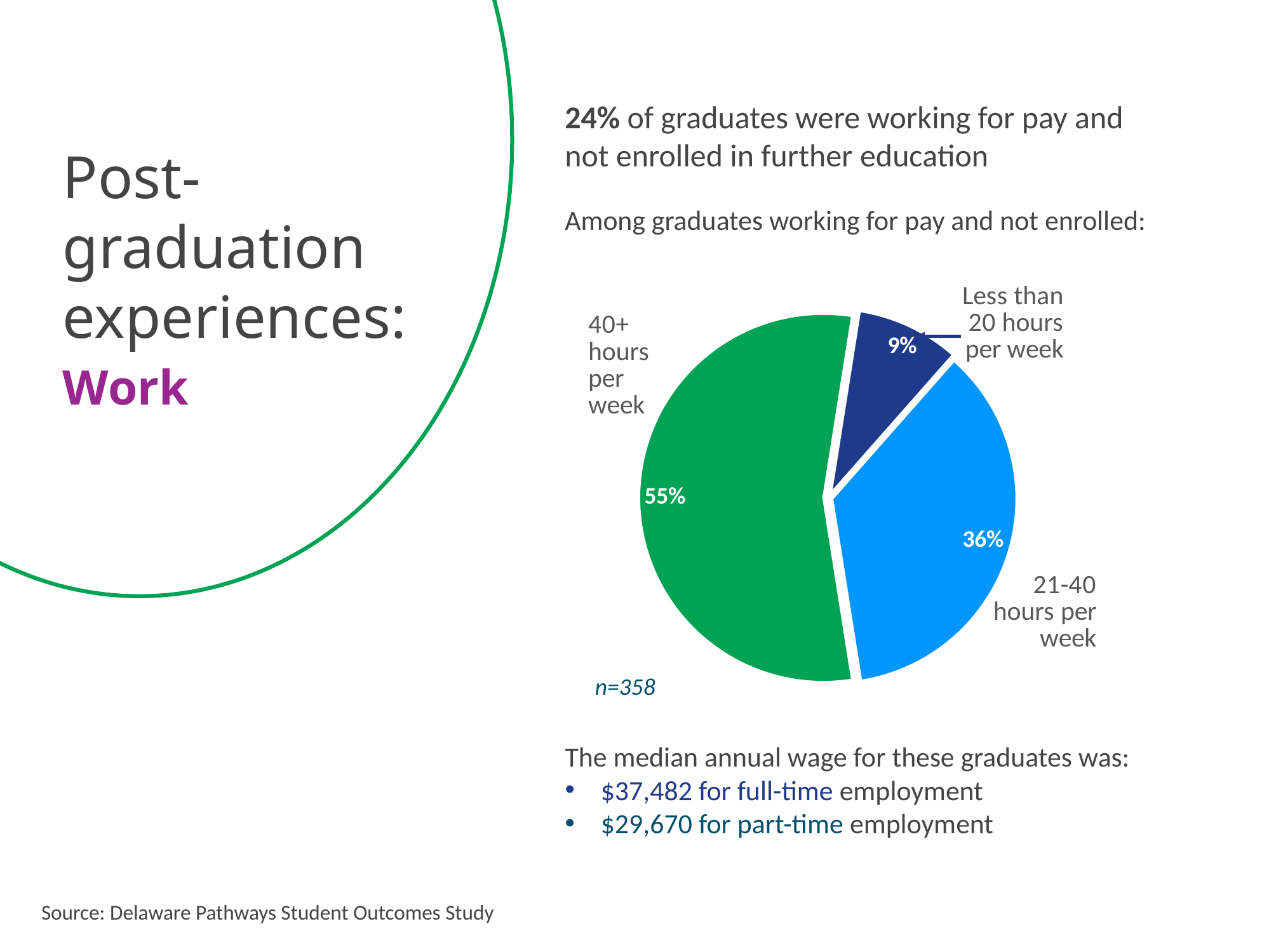
Which category has the smallest slice of the pie chart? Less than 20 hours per week What share of graduates working for pay and not enrolled worked 40+ hours per week? 55% What is the sample size (n) shown for the pie chart? n=358 What colour is the slice for 40+ hours per week? Green What is the difference in percentage points between the 21-40 hours per week slice and the less than 20 hours per week slice? 27 How many categories does the pie chart show? 3 Which is larger: the share working 21-40 hours per week or the share working less than 20 hours per week? 21-40 hours per week What share of graduates working for pay and not enrolled worked less than 20 hours per week? 9% What is the difference in percentage points between the 40+ hours per week slice and the 21-40 hours per week slice? 19 What kind of chart is shown on the slide? Pie chart What share of graduates working for pay and not enrolled worked 21-40 hours per week? 36% Which category has the largest slice of the pie chart? 40+ hours per week